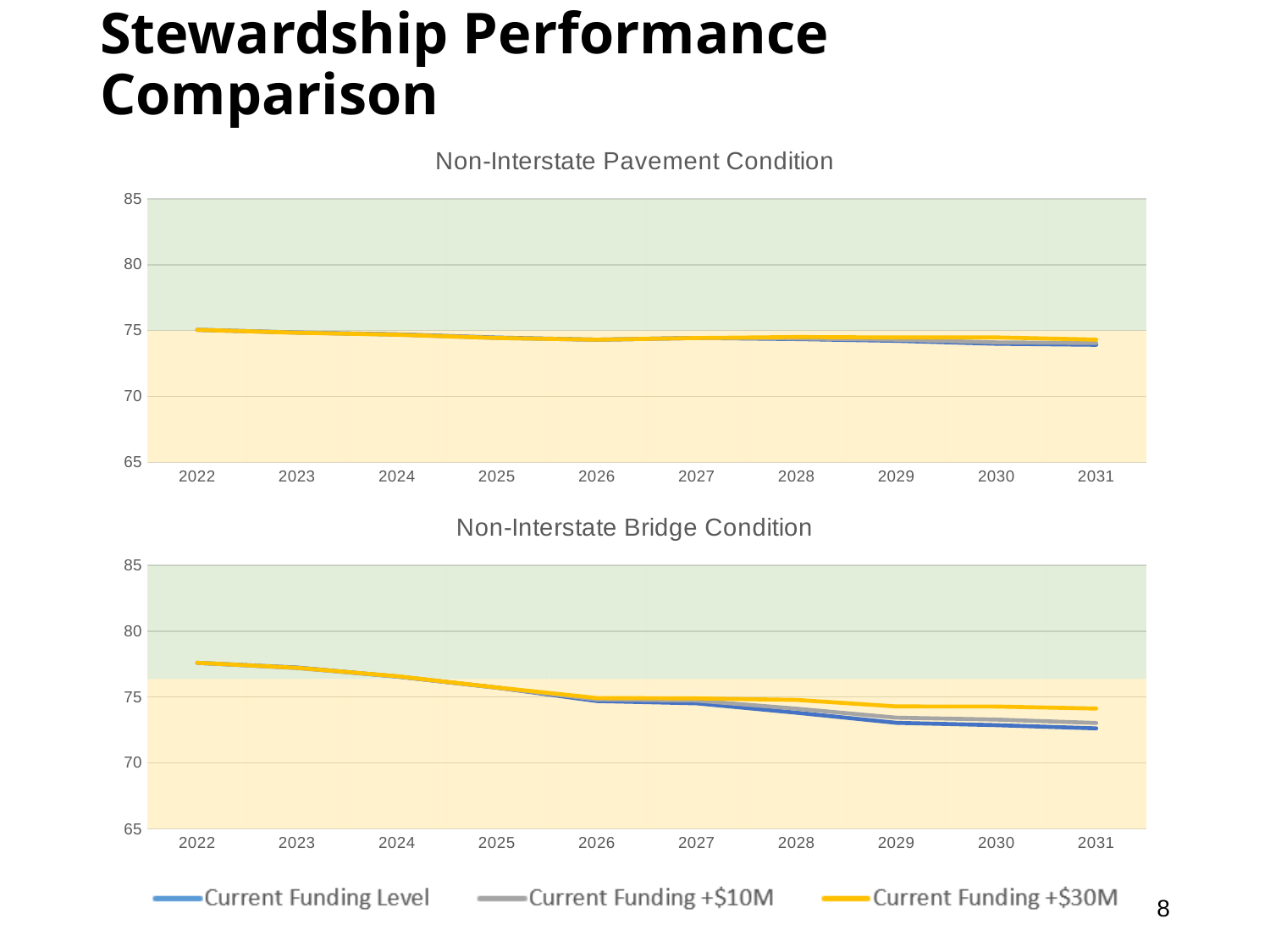
What is the title of the lower chart on the slide? Non-Interstate Bridge Condition How many series does the legend list for the charts on the slide? 3 In the Non-Interstate Bridge Condition chart, which series has the higher value in 2031: Current Funding +$30M or Current Funding Level? Current Funding +$30M What kind of chart is the Non-Interstate Bridge Condition chart? line chart In the Non-Interstate Bridge Condition chart, is the value for 2022 greater or less than 75? greater How many years are plotted on the x axis of the Non-Interstate Bridge Condition chart? 10 In the Non-Interstate Bridge Condition chart, do the values rise or fall from 2022 to 2031? fall In the Non-Interstate Pavement Condition chart, do the values rise or fall from 2022 to 2031? fall In the Non-Interstate Pavement Condition chart, is the Current Funding Level value for 2031 greater or less than 75? less In the Non-Interstate Pavement Condition chart, is the value for 2022 greater or less than 80? less What kind of chart is the Non-Interstate Pavement Condition chart? line chart